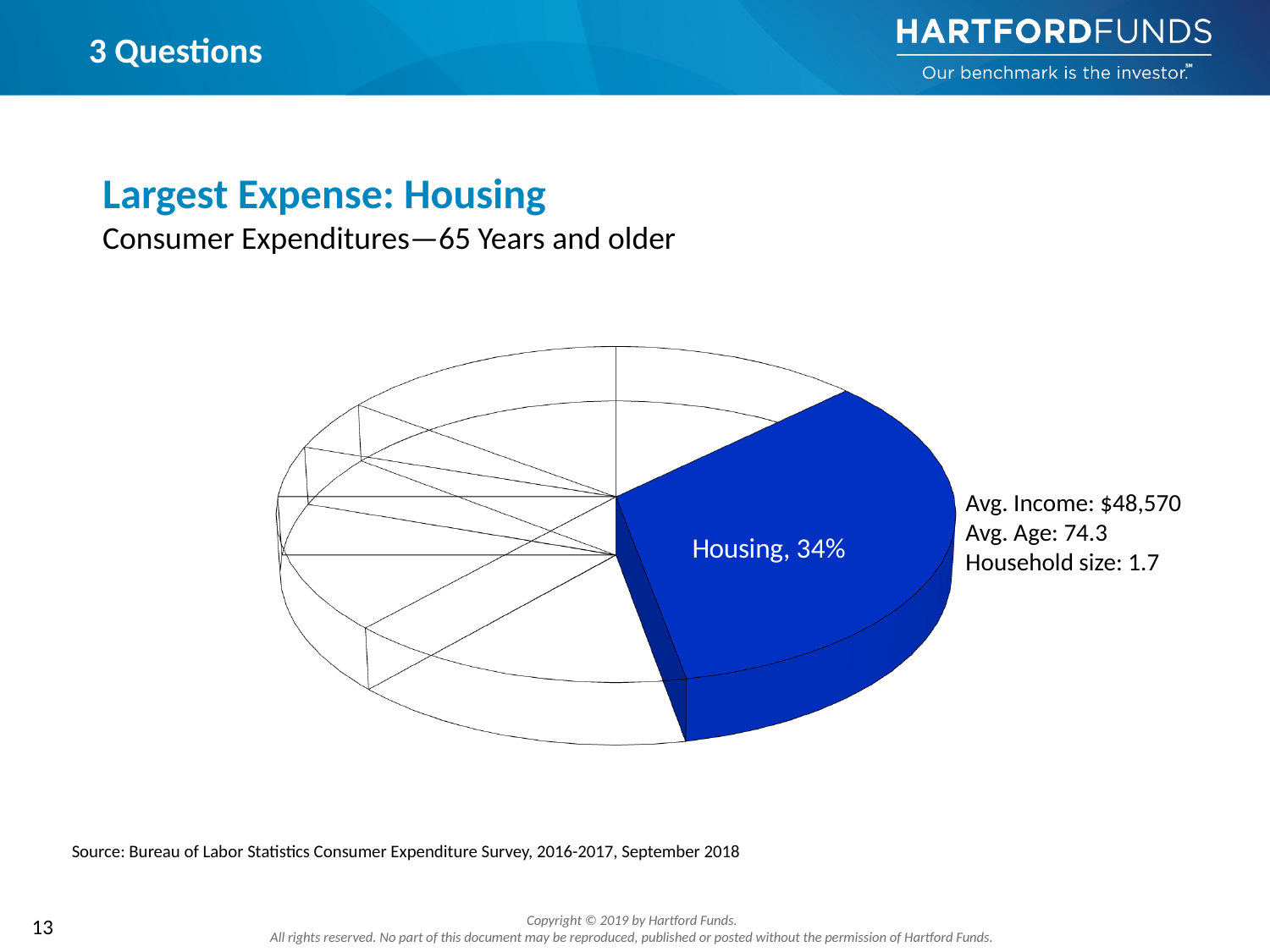
Is the Housing slice greater or less than half of the pie? less What share of consumer expenditures does the Housing slice represent? 34% What kind of chart is shown on the slide? pie chart What colour is the Housing slice in the pie chart? blue Which slice of the pie chart is the largest? Housing What is the title of the chart on the slide? Largest Expense: Housing What is the value printed on the Housing slice of the pie chart? 34%